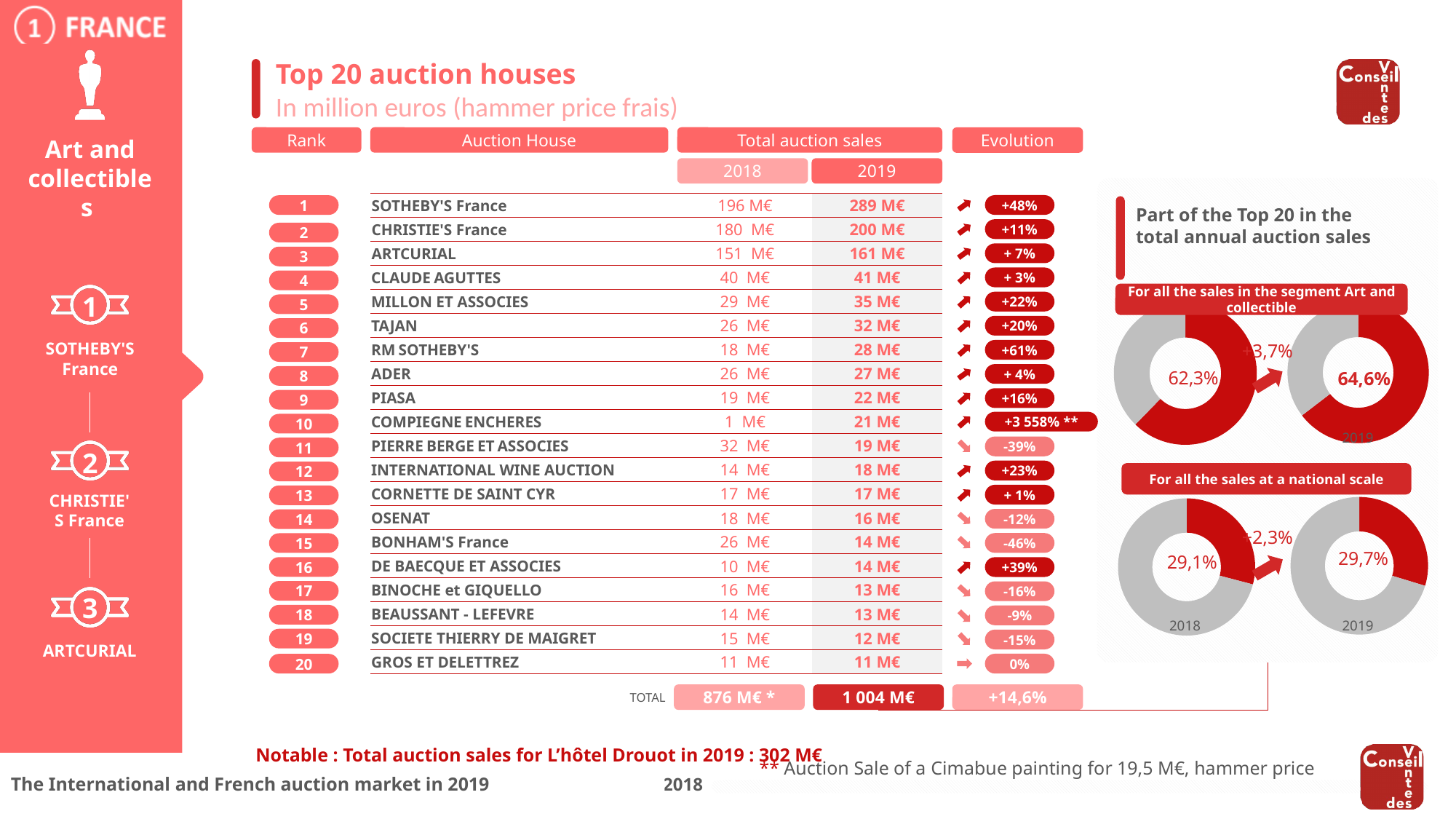
For 2019, which share is larger: the Top 20's share in the Art and collectible segment or its share at a national scale? Art and collectible segment In the 'For all the sales at a national scale' charts, what share is shown for 2018? 29,1% In the 'For all the sales in the segment Art and collectible' charts, what share is shown for the left (2018) donut? 62,3% What change is printed on the arrow between the two 'segment Art and collectible' donuts? +3,7% In the 'For all the sales at a national scale' charts, what share is shown for 2019? 29,7% In the 'For all the sales in the segment Art and collectible' charts, what share is shown for 2019? 64,6% In the 'national scale' charts, does the share of the Top 20 rise or fall from 2018 to 2019? Rise What kind of charts are used under 'Part of the Top 20 in the total annual auction sales'? Donut (pie) charts In the 'segment Art and collectible' charts, which year has the larger share, 2018 or 2019? 2019 How many donut charts are shown on the slide? 4 What change is printed on the arrow between the two 'national scale' donuts? +2,3% What is the heading above the donut charts on the right of the slide? Part of the Top 20 in the total annual auction sales